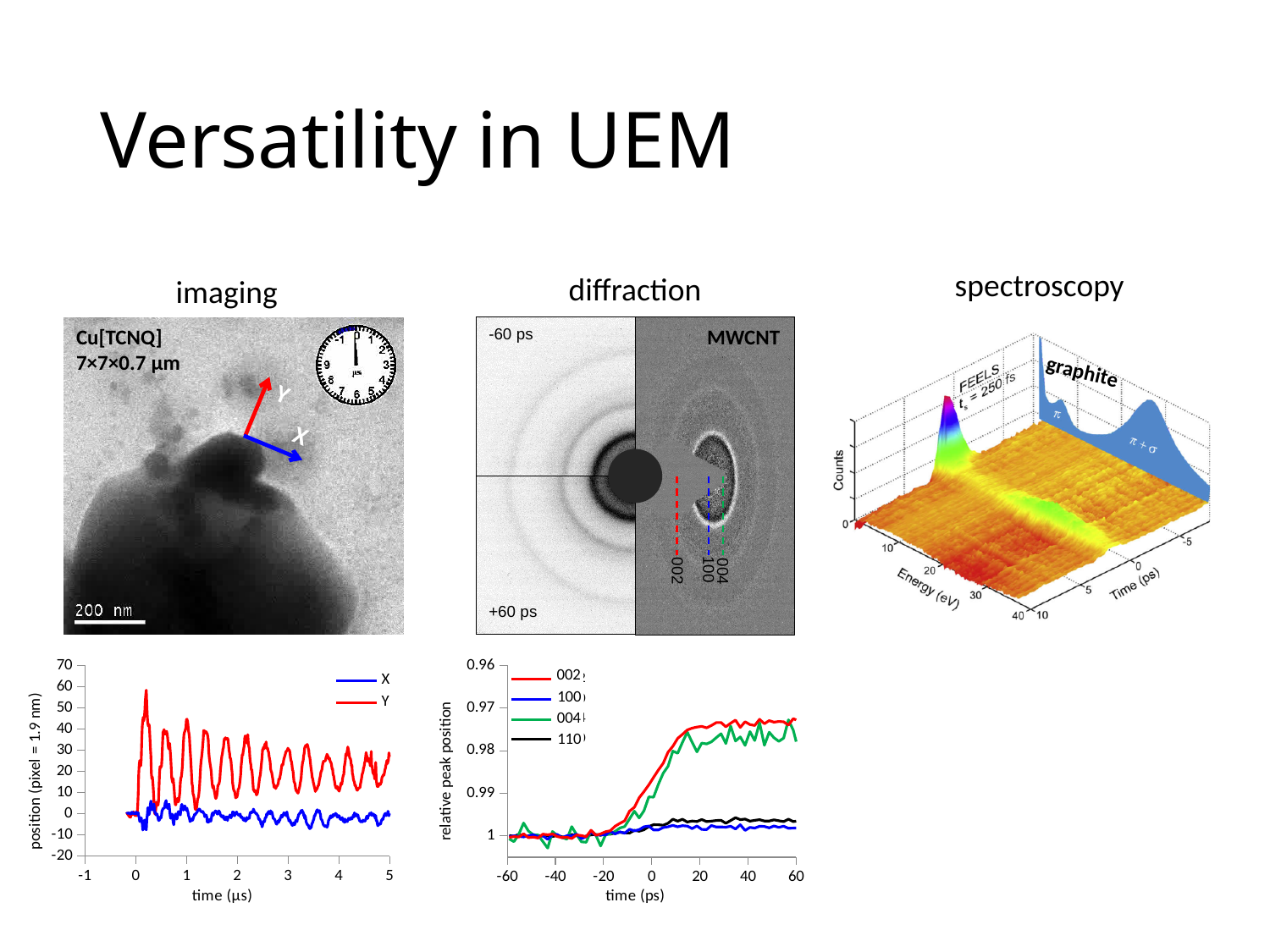
In the bottom-left chart (position vs time in µs), do the peaks of the Y series rise or fall as time increases? fall What kind of chart is the bottom-left chart (position vs time in µs)? line chart In the bottom-left chart (position vs time in µs), which series reaches a higher peak value, X or Y? Y In the bottom-middle chart (relative peak position vs time in ps), does the relative peak position of the 002 series increase or decrease from -60 ps to 60 ps? decrease In the bottom-middle chart (relative peak position vs time in ps), is the value of the 002 series at 40 ps greater or less than 0.98? less In the bottom-left chart (position vs time in µs), is the value of the X series at 4 µs greater or less than 20? less In the bottom-middle chart (relative peak position vs time in ps), which series shows a larger change in relative peak position, 002 or 110? 002 What kind of chart is the bottom-middle chart (relative peak position vs time in ps)? line chart In the bottom-left chart (position vs time in µs), is the highest value of the Y series greater or less than 50? greater How many series does the legend of the bottom-left chart (position vs time in µs) list? 2 How many series does the legend of the bottom-middle chart (relative peak position vs time in ps) list? 4 In the bottom-middle chart (relative peak position vs time in ps), what colour is the 004 series? green